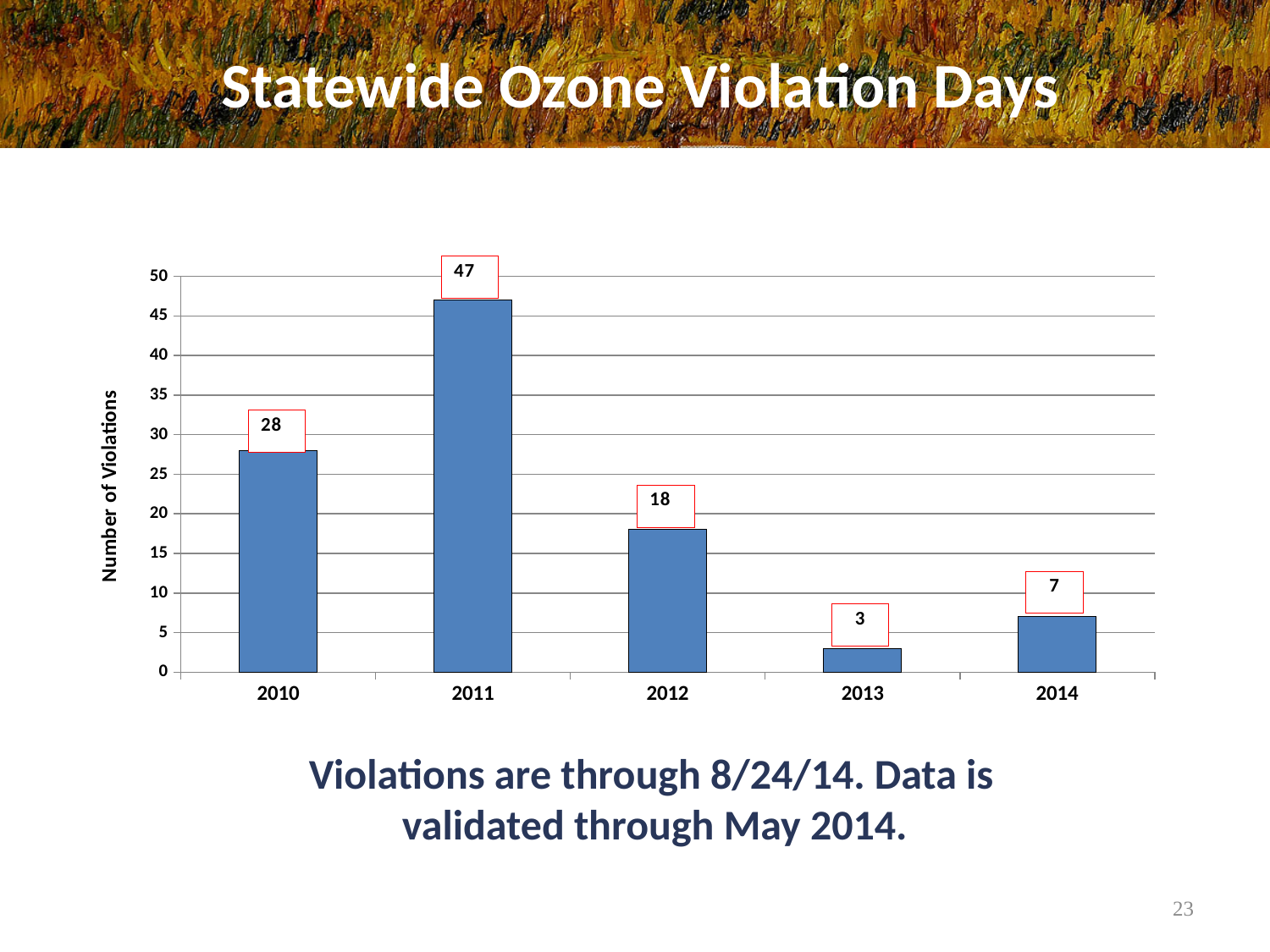
What is the difference in violations between 2011 and 2010? 19 How many years are shown on the x axis? 5 What is the number of violations for 2013? 3 Which year has the lowest number of violations? 2013 What is the label of the vertical axis? Number of Violations What kind of chart is shown on the slide? Bar chart What is the number of violations for 2011? 47 Which year has the highest number of violations? 2011 Is the value for 2010 greater or less than 25? greater Which year had more violations, 2010 or 2012? 2010 What is the number of violations for 2014? 7 What is the difference in violations between 2012 and 2014? 11